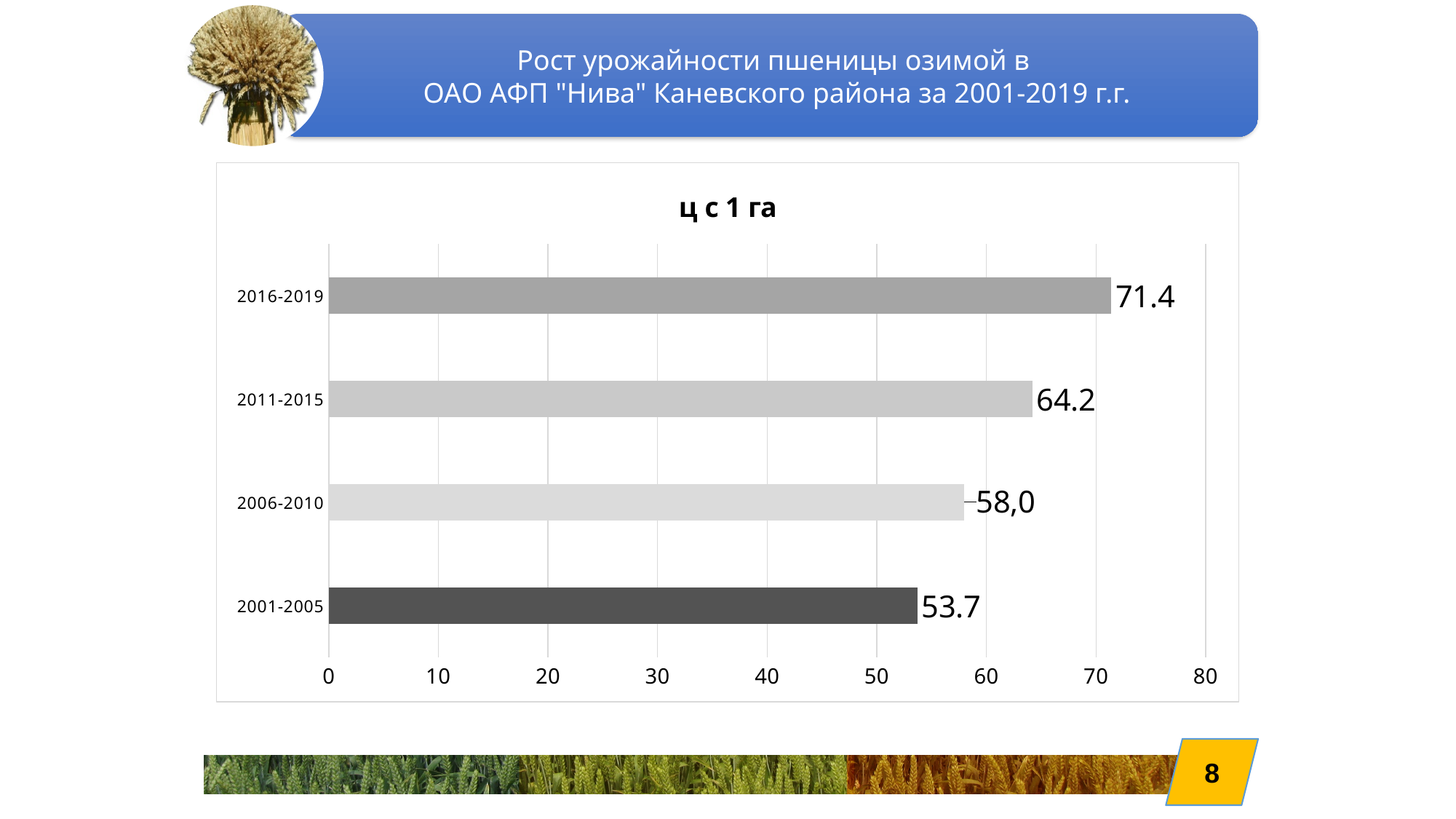
What is the difference between the values for 2016-2019 and 2001-2005? 17.7 How many periods (categories) are shown in the chart? 4 What is the value for 2001-2005 in the chart? 53.7 What is the difference between the values for 2016-2019 and 2011-2015? 7.2 What is the value for 2011-2015 in the chart? 64.2 Do the values rise or fall from the earliest period (2001-2005) to the latest period (2016-2019)? rise Which period has the lowest value in the chart? 2001-2005 What is the value for 2016-2019 in the chart? 71.4 What kind of chart is shown on the slide? bar chart Which period has the highest value in the chart? 2016-2019 What is the value for 2006-2010 in the chart? 58,0 Which is larger, the value for 2011-2015 or the value for 2006-2010? 2011-2015